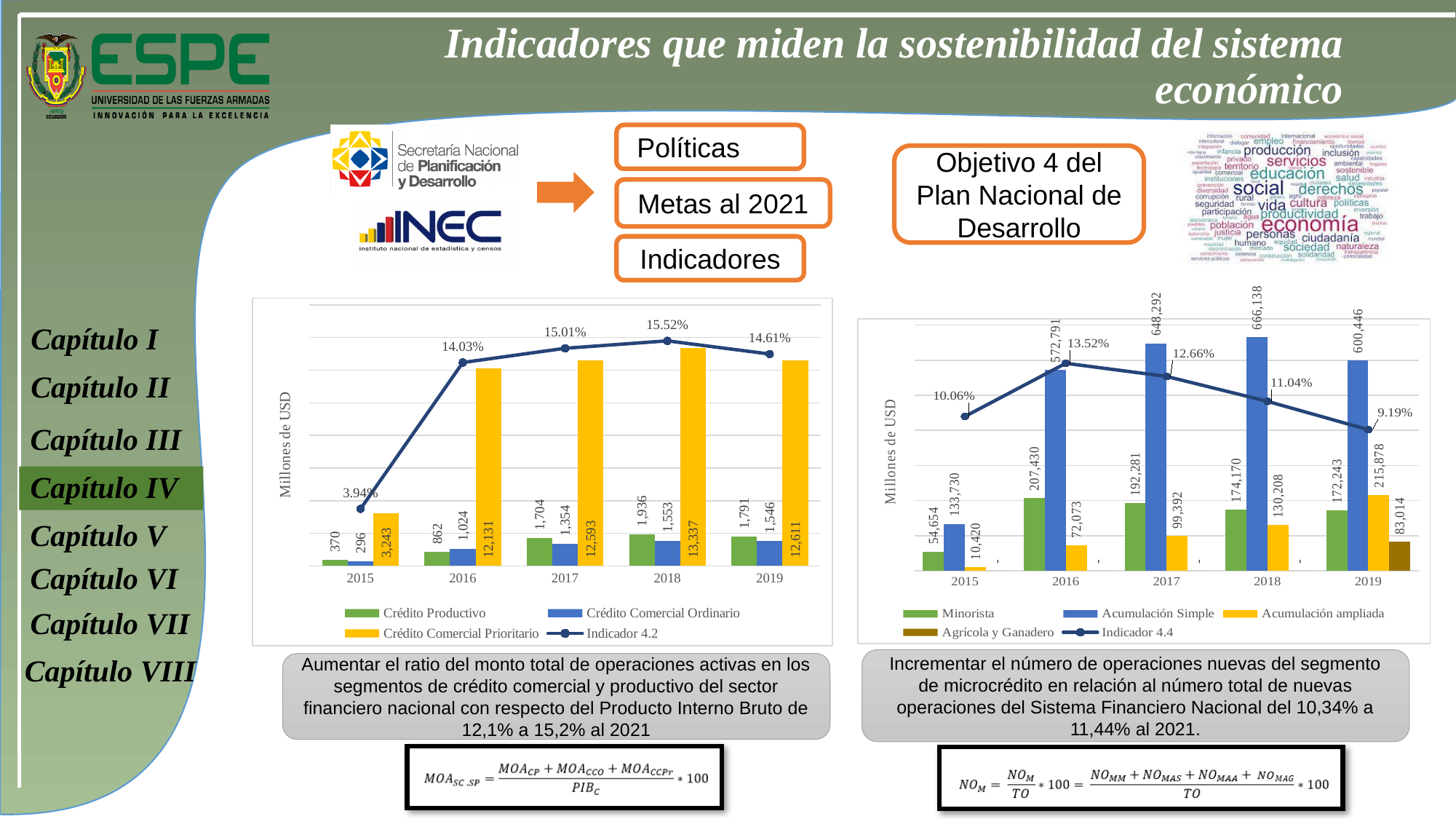
In the left chart, how many series does the legend list? 4 In the right chart, what is the value of Acumulación Simple in 2017? 648,292 In the right chart, what is the Indicador 4.4 value for 2019? 9.19% In the left chart, does Indicador 4.2 rise or fall from 2015 to 2018? rise In the left chart, what is the Indicador 4.2 value for 2015? 3.94% In the left chart, what is the difference between Crédito Productivo and Crédito Comercial Ordinario in 2017? 350 In the left chart, what is the value of Crédito Comercial Prioritario in 2018? 13,337 In the right chart, in which year is Minorista lowest? 2015 In the right chart, which is larger in 2019: Acumulación ampliada or Agrícola y Ganadero? Acumulación ampliada In the left chart, in which year is Indicador 4.2 highest? 2018 In the right chart, does Indicador 4.4 rise or fall from 2016 to 2019? fall How many years are shown on the x axis of the right chart? 5